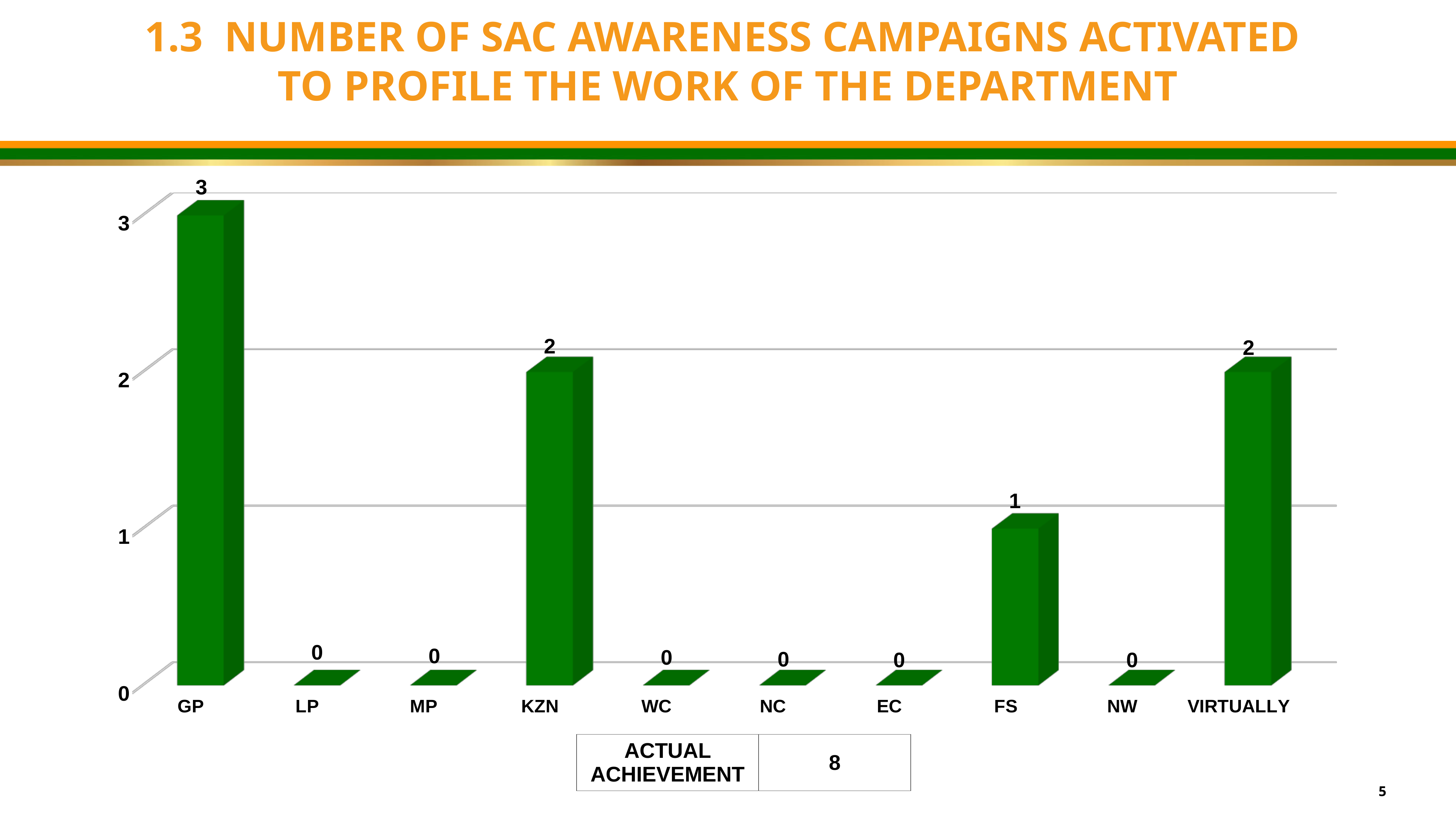
How many categories are shown on the x axis? 10 Which category has the highest value? GP Which is larger, the value for KZN or the value for FS? KZN What is the difference between the values for GP and FS? 2 What is the value for FS? 1 What is the value for NW? 0 How many categories have a value of 0? 6 What is the ACTUAL ACHIEVEMENT figure shown below the chart? 8 What is the value for GP? 3 What is the value for VIRTUALLY? 2 What is the value for KZN? 2 What kind of chart is shown on the slide? bar chart